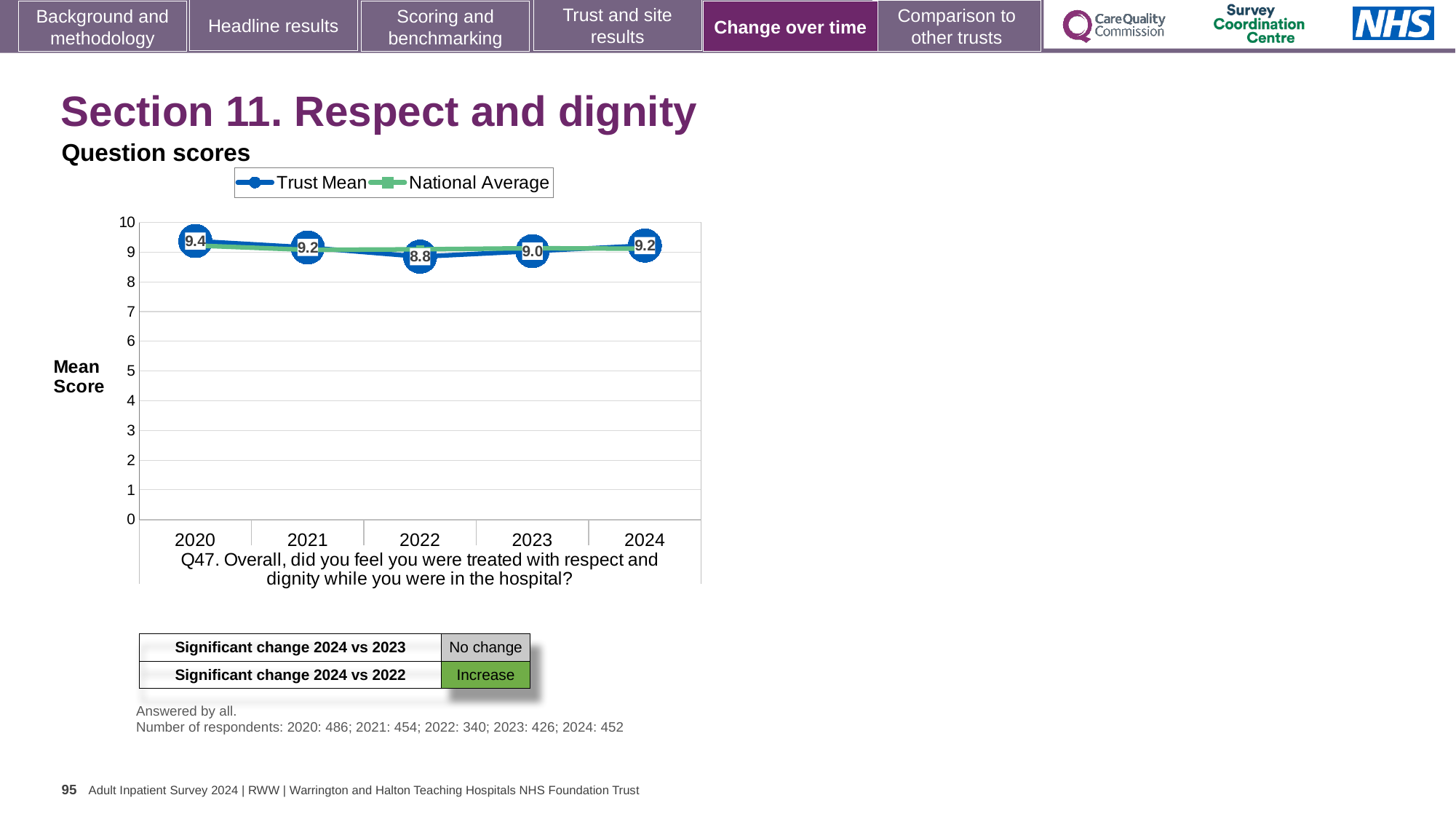
How many series does the legend list? 2 What is the Trust Mean score for 2024? 9.2 Is the National Average value for 2022 greater or less than 8? greater In which year is the Trust Mean score highest? 2020 Which is larger, the Trust Mean score for 2021 or for 2022? 2021 What is the difference between the Trust Mean score in 2020 and in 2022? 0.6 What is the Trust Mean score for 2022? 8.8 What is the Trust Mean score for 2020? 9.4 Does the Trust Mean score rise or fall from 2022 to 2024? Rise How many years are plotted on the x axis? 5 What kind of chart is shown? Line chart In which year is the Trust Mean score lowest? 2022